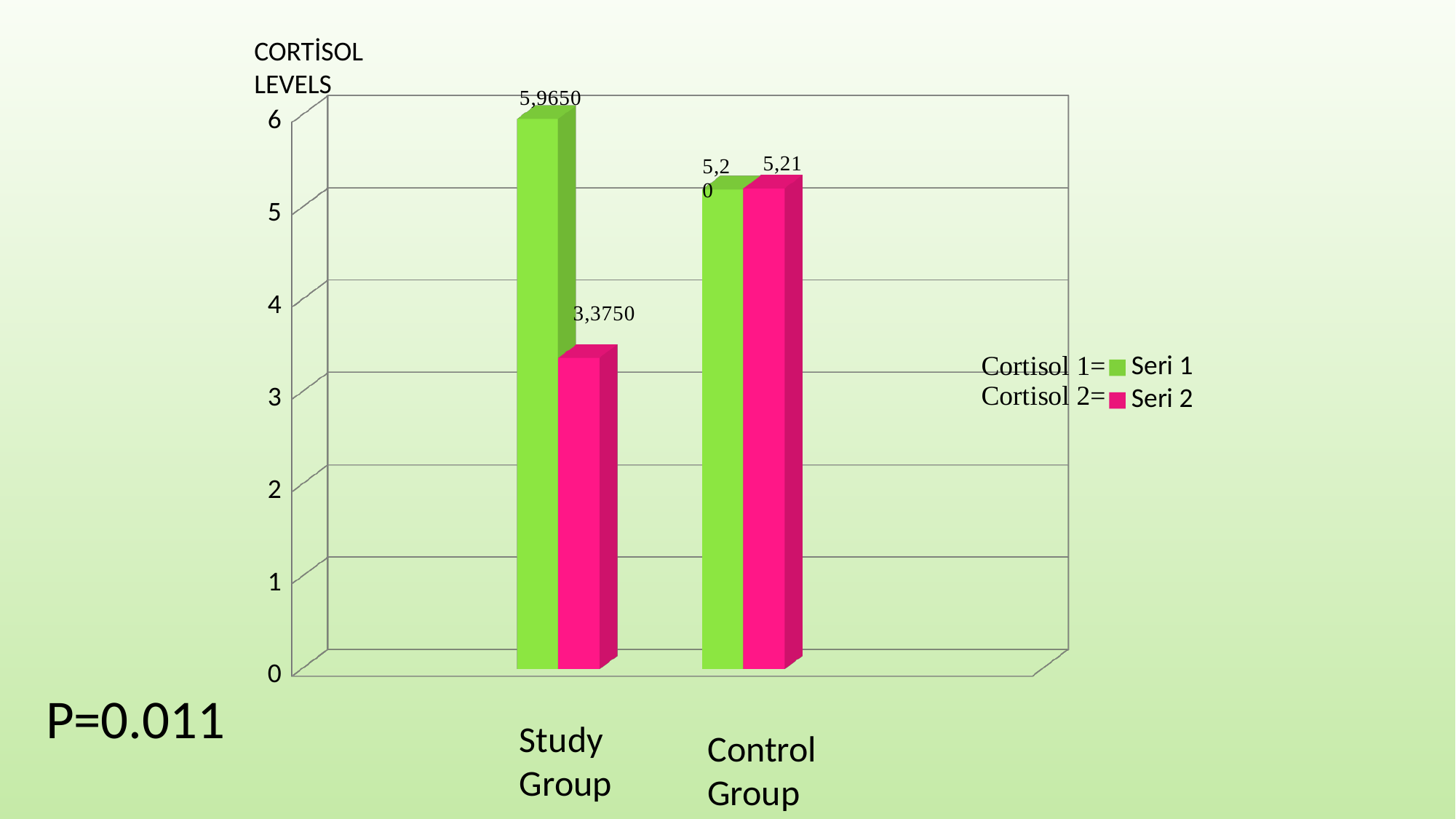
For the Study Group, which is larger, Seri 1 or Seri 2? Seri 1 What kind of chart is shown on the slide? bar chart How many series does the legend list? 2 How many groups are shown on the x axis? 2 What is the difference between Seri 1 and Seri 2 for the Study Group? 2,5900 Is the value of Seri 2 for the Study Group greater or less than 4? less Which bar is the tallest in the chart? Seri 1 for the Study Group What is the value of Seri 2 for the Study Group? 3,3750 What is the value of Seri 2 for the Control Group? 5,21 What colour are the Seri 2 bars? pink Which bar is the shortest in the chart? Seri 2 for the Study Group What is the value of Seri 1 for the Study Group? 5,9650